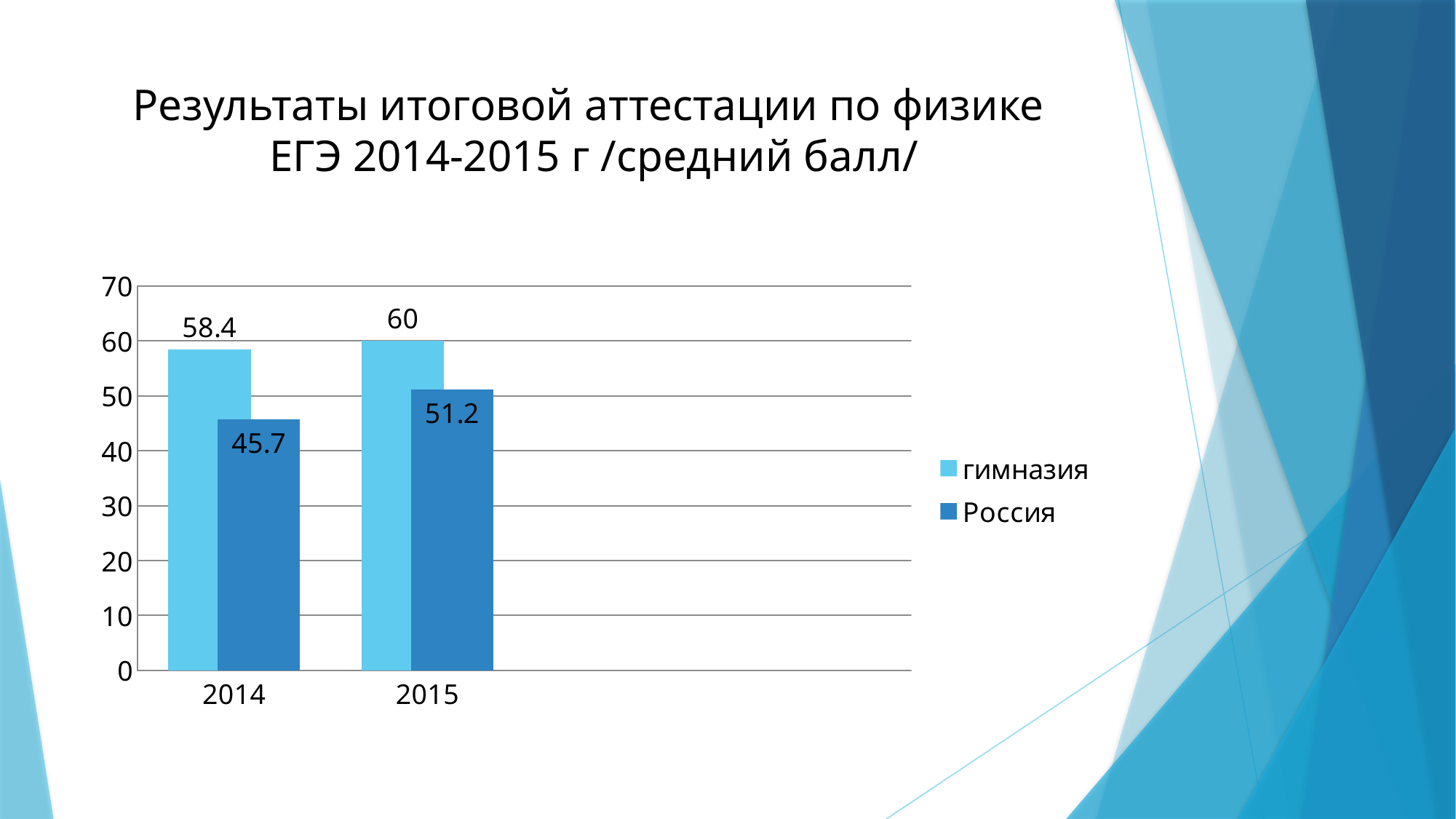
What is the value for Россия in 2014? 45.7 What is the difference between the гимназия and Россия values in 2015? 8.8 What is the difference between the гимназия and Россия values in 2014? 12.7 How many series does the legend list? 2 What is the value for гимназия in 2015? 60 Which bar has the highest value on the chart? гимназия in 2015 Which series has the higher value in 2014, гимназия or Россия? гимназия Which bar has the lowest value on the chart? Россия in 2014 What kind of chart is shown on the slide? bar chart What is the value for Россия in 2015? 51.2 What is the value for гимназия in 2014? 58.4 Does the value for Россия rise or fall from 2014 to 2015? rise